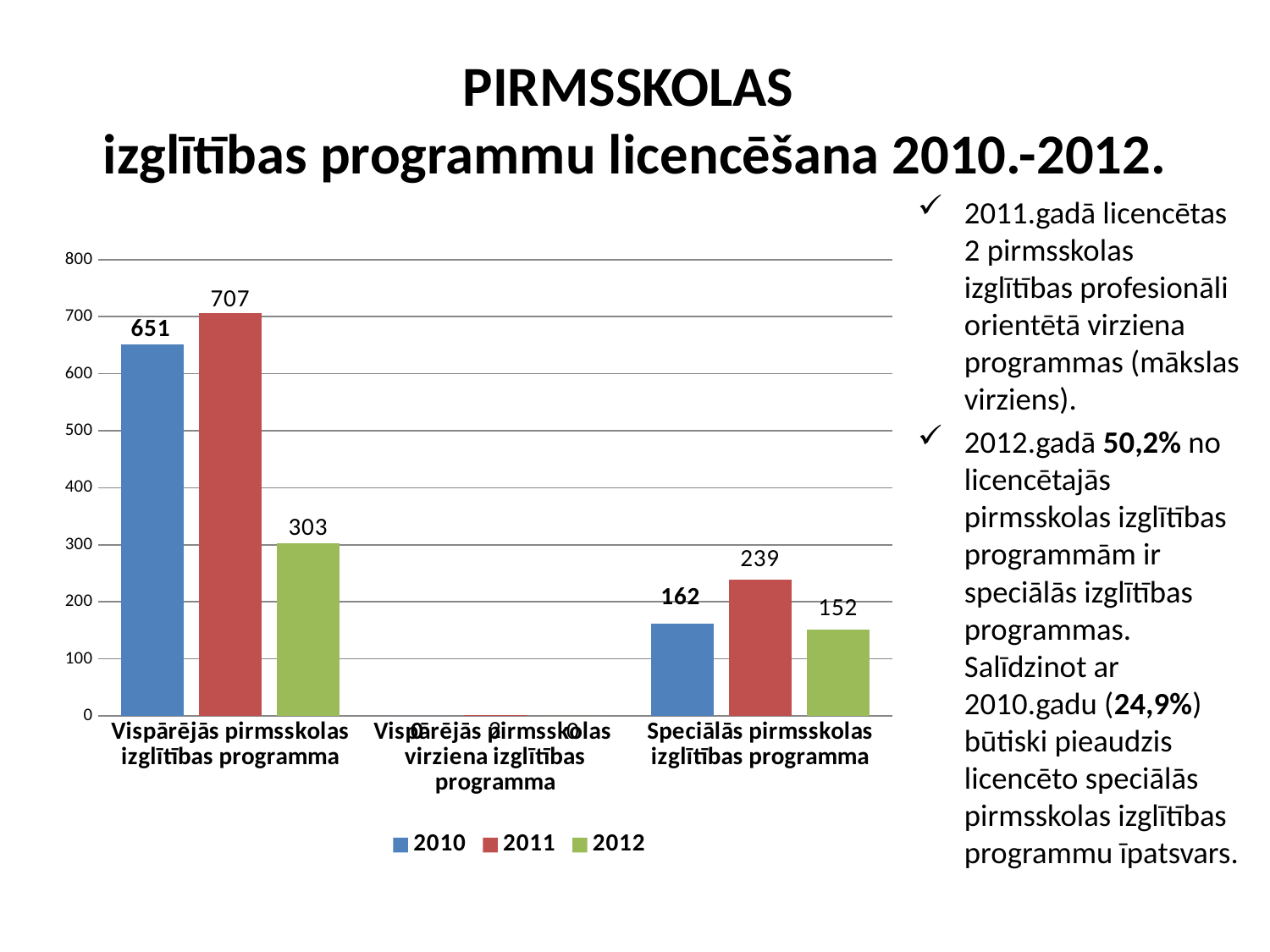
Which is larger in the category Speciālās pirmsskolas izglītības programma: the 2010 value or the 2011 value? 2011 Which year has the highest value in the category Vispārējās pirmsskolas izglītības programma? 2011 What is the value for 2012 in the category Speciālās pirmsskolas izglītības programma? 152 How many categories are shown on the x axis? 3 What is the value for 2011 in the category Vispārējās pirmsskolas izglītības programma? 707 What is the value for 2010 in the category Vispārējās pirmsskolas izglītības programma? 651 How many series does the legend list? 3 What kind of chart is shown on the slide? bar chart What is the difference between the 2011 and 2012 values in the category Vispārējās pirmsskolas izglītības programma? 404 Which legend entry is shown in red? 2011 Which year has the lowest value in the category Speciālās pirmsskolas izglītības programma? 2012 What is the value for 2011 in the category Speciālās pirmsskolas izglītības programma? 239